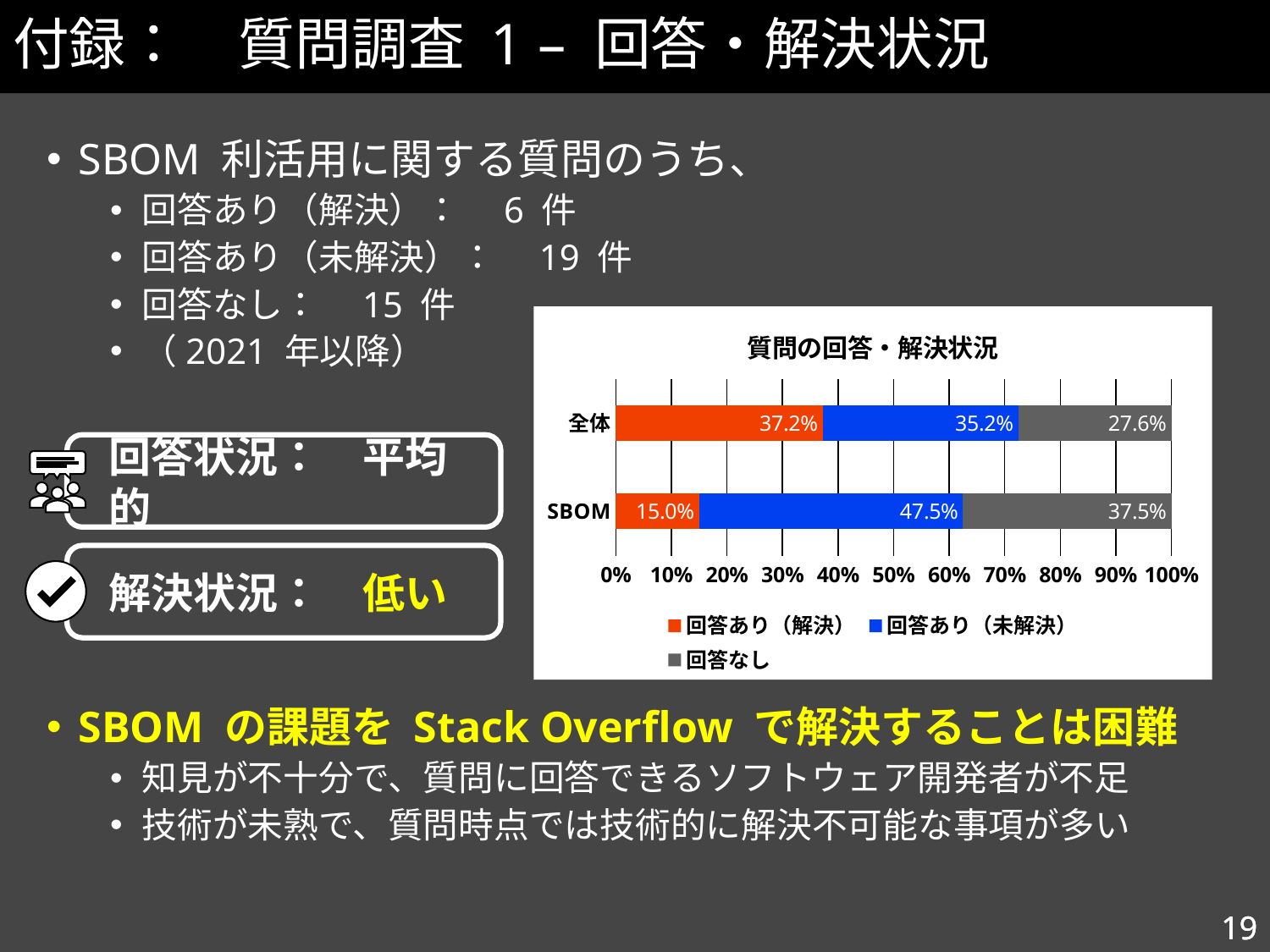
How many series does the legend list? 3 What type of chart is shown? Stacked bar chart What is the value of 回答なし for SBOM? 37.5% Which category has the higher value for 回答あり（解決）, 全体 or SBOM? 全体 Which series has the smallest value in the SBOM bar? 回答あり（解決） What is the difference between the 回答なし values for SBOM and 全体? 9.9% Which series has the largest value in the SBOM bar? 回答あり（未解決） What is the value of 回答あり（未解決） for SBOM? 47.5% How many categories are shown on the chart? 2 What is the value of 回答あり（解決） for SBOM? 15.0% What is the value of 回答あり（解決） for 全体? 37.2% What is the difference between the 回答あり（解決） values for 全体 and SBOM? 22.2%